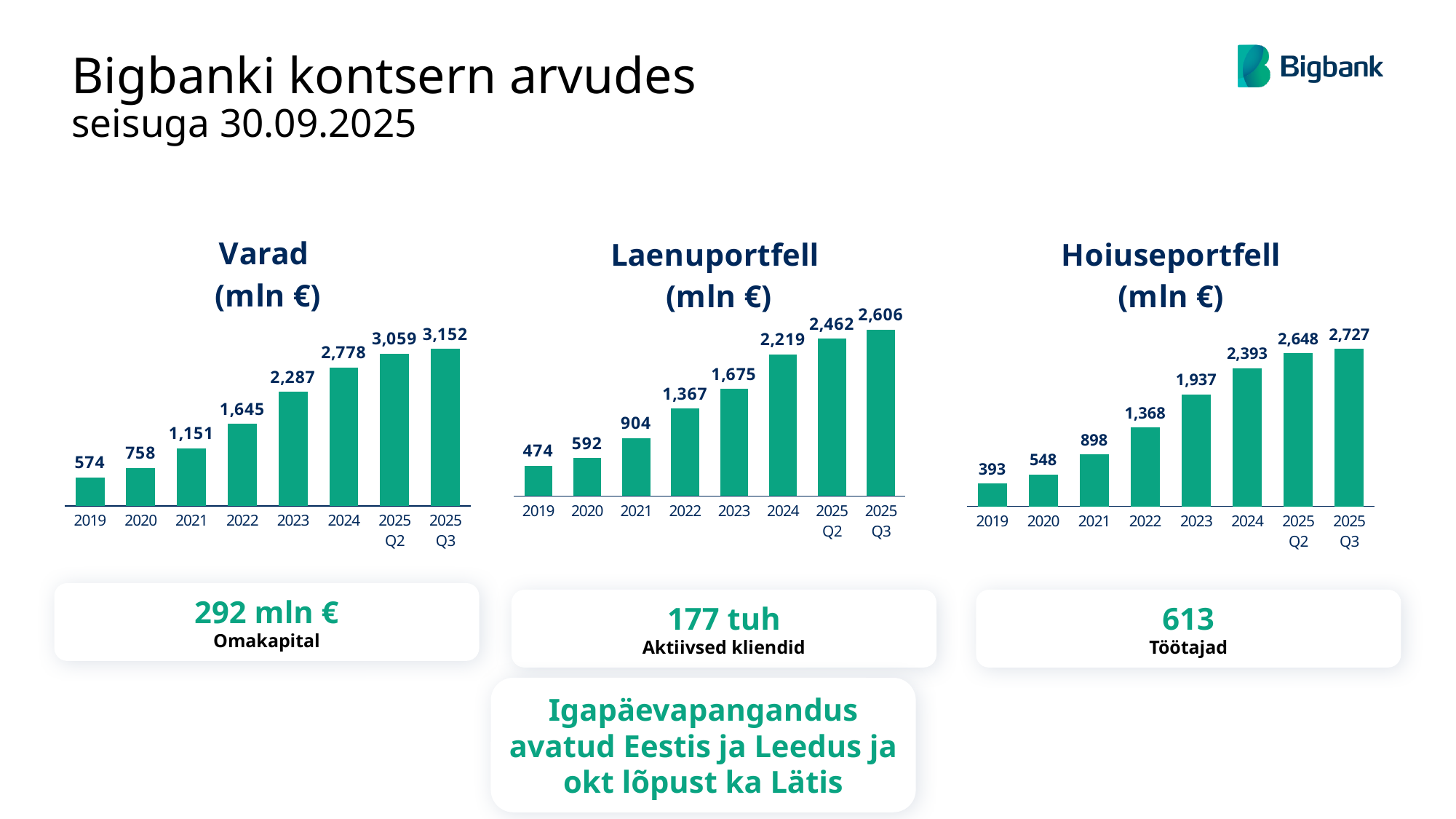
In the Laenuportfell (mln €) chart, what is the difference between the values for 2024 and 2023? 544 In the Hoiuseportfell (mln €) chart, do the values rise or fall from 2019 to 2025 Q3? rise How many charts are shown on the slide? 3 What kind of chart is the Varad (mln €) chart? bar chart In the Varad (mln €) chart, what is the difference between the values for 2025 Q3 and 2025 Q2? 93 In the Hoiuseportfell (mln €) chart, which category has the highest value? 2025 Q3 In the Varad (mln €) chart, which category has the lowest value? 2019 How many categories are shown on the x axis of the Laenuportfell (mln €) chart? 8 In the Varad (mln €) chart, what is the value for 2023? 2,287 In the Hoiuseportfell (mln €) chart, which is larger, the value for 2022 or the value for 2023? 2023 In the Laenuportfell (mln €) chart, what is the value for 2025 Q3? 2,606 In the Hoiuseportfell (mln €) chart, what is the value for 2021? 898